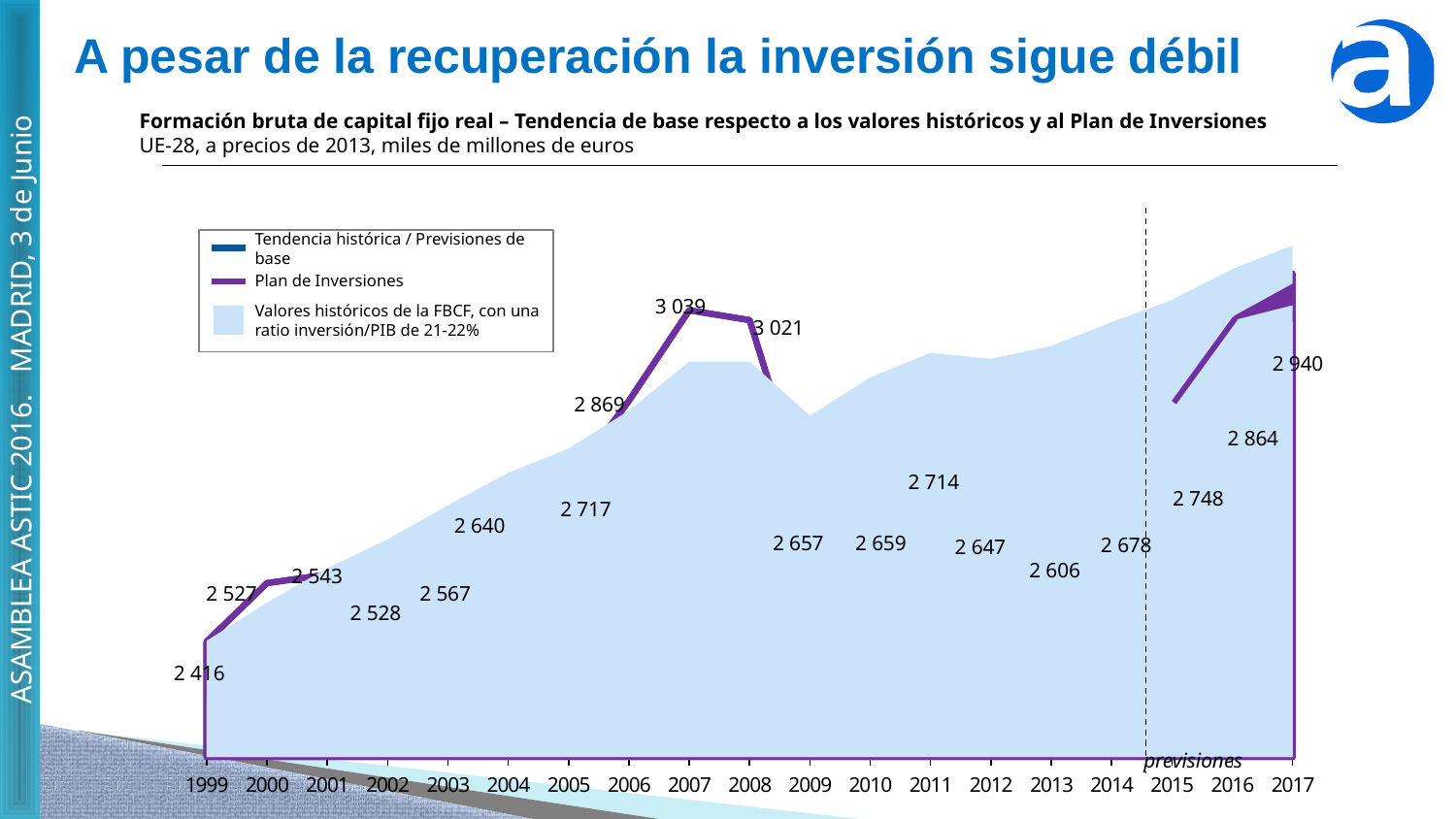
What is the value shown for 2011? 2 714 What is the difference between the values for 2017 and 1999? 524 Which year has the larger value, 2008 or 2009? 2008 How many years are shown on the x axis? 19 What is the value shown for 2017? 2 940 What is the value shown for 1999? 2 416 How many entries does the legend list? 3 What kind of chart is shown on the slide? Area chart What is the value shown for 2013? 2 606 Which year has the highest value on the chart? 2007 Which year has the lowest value on the chart? 1999 Do the values rise or fall from 2008 to 2009? Fall